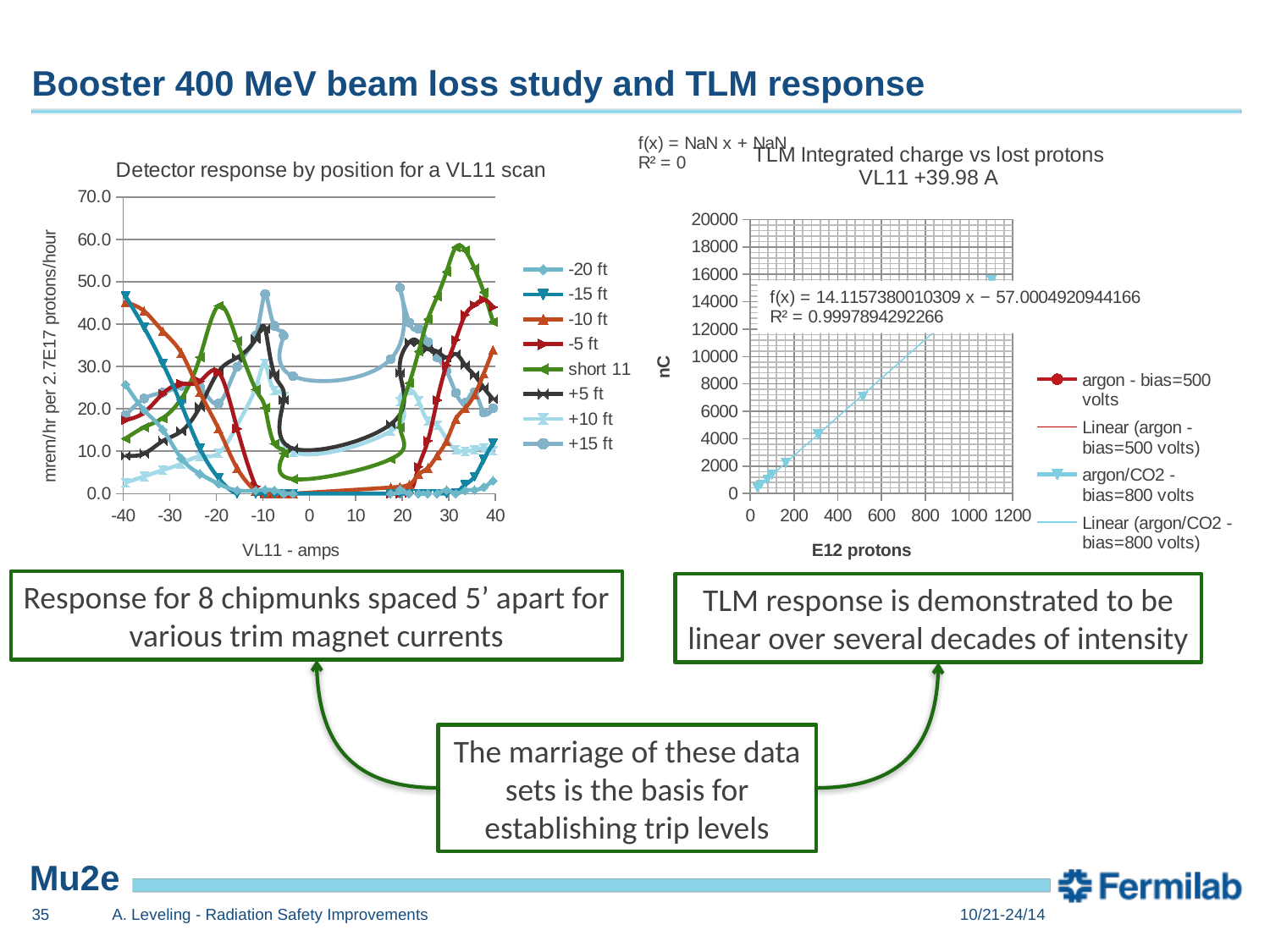
In 'Detector response by position for a VL11 scan', is the peak of the '+15 ft' series greater or less than 40.0? greater In 'TLM Integrated charge vs lost protons VL11 +39.98 A', is the highest plotted 'argon/CO2 - bias=800 volts' point greater or less than 10000 nC? greater In 'Detector response by position for a VL11 scan', which series reaches the highest peak value? short 11 How many tick labels are shown on the x axis of 'Detector response by position for a VL11 scan'? 9 How many entries does the legend of 'TLM Integrated charge vs lost protons VL11 +39.98 A' list? 4 In 'Detector response by position for a VL11 scan', is the peak value of the 'short 11' series greater or less than 50.0? greater How many series does the legend of 'Detector response by position for a VL11 scan' list? 8 What kind of chart is 'Detector response by position for a VL11 scan'? line chart In 'TLM Integrated charge vs lost protons VL11 +39.98 A', do the plotted nC values rise or fall as E12 protons increases? rise What R² value is printed on the 'TLM Integrated charge vs lost protons VL11 +39.98 A' chart? 0.9997894292266 What is the slope in the fit equation printed on the 'TLM Integrated charge vs lost protons VL11 +39.98 A' chart? 14.1157380010309